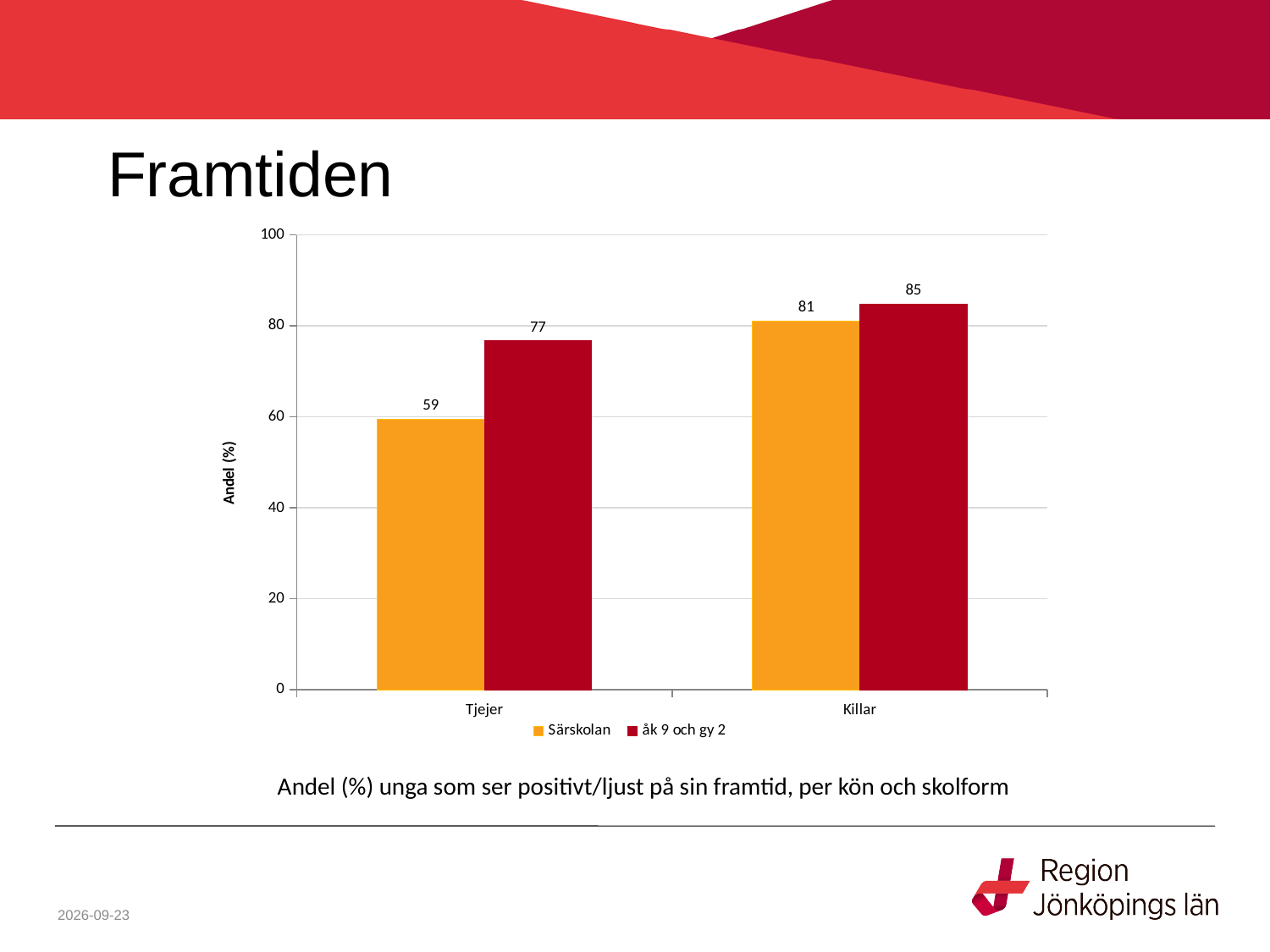
How many categories are shown on the x axis? 2 What is the difference between the Särskolan values for Killar and Tjejer? 22 Which is larger: the Särskolan value for Killar or the åk 9 och gy 2 value for Tjejer? Särskolan value for Killar What is the value for åk 9 och gy 2 in the Tjejer category? 77 What is the difference between the åk 9 och gy 2 and Särskolan values for Tjejer? 18 What kind of chart is shown on the slide? Bar chart What is the value for Särskolan in the Killar category? 81 How many series does the legend list? 2 What is the value for åk 9 och gy 2 in the Killar category? 85 What is the value for Särskolan in the Tjejer category? 59 Which bar has the lowest value in the chart? Särskolan, Tjejer Which bar has the highest value in the chart? åk 9 och gy 2, Killar